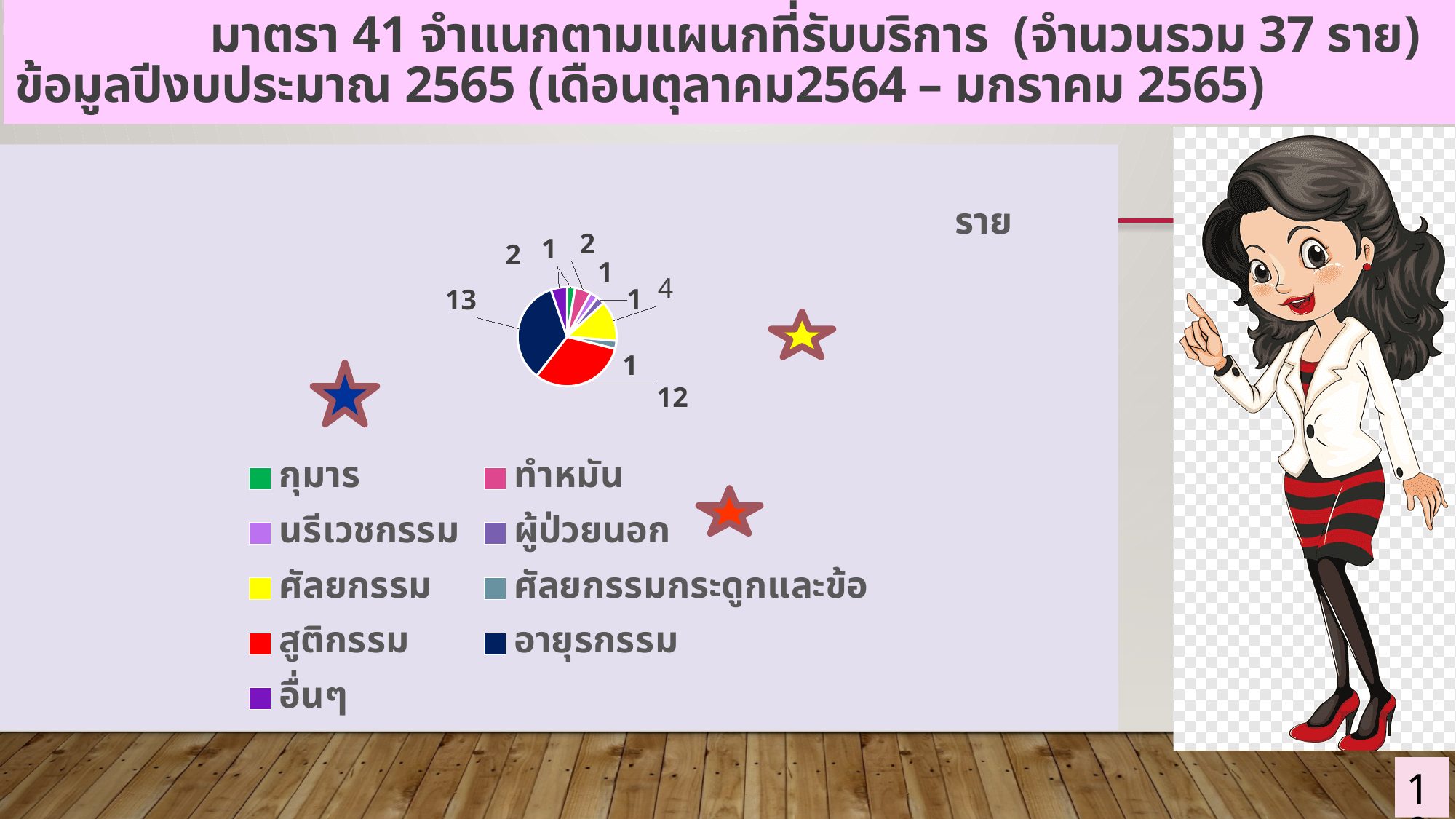
Which category has the largest slice in the pie chart? อายุรกรรม What is the difference between the values for สูติกรรม and ศัลยกรรม? 8 What colour is the slice for อายุรกรรม in the pie chart? navy blue What is the difference between the values for อายุรกรรม and สูติกรรม? 1 What is the value for อายุรกรรม in the pie chart? 13 What is the value for ศัลยกรรมกระดูกและข้อ in the pie chart? 1 Which is larger, the value for ศัลยกรรม or the value for สูติกรรม? สูติกรรม What is the value for สูติกรรม in the pie chart? 12 What is the value for ศัลยกรรม in the pie chart? 4 What kind of chart is shown on the slide? pie chart According to the slide title, what is the total number of cases (ราย) shown in the chart? 37 How many categories does the pie chart's legend list? 9